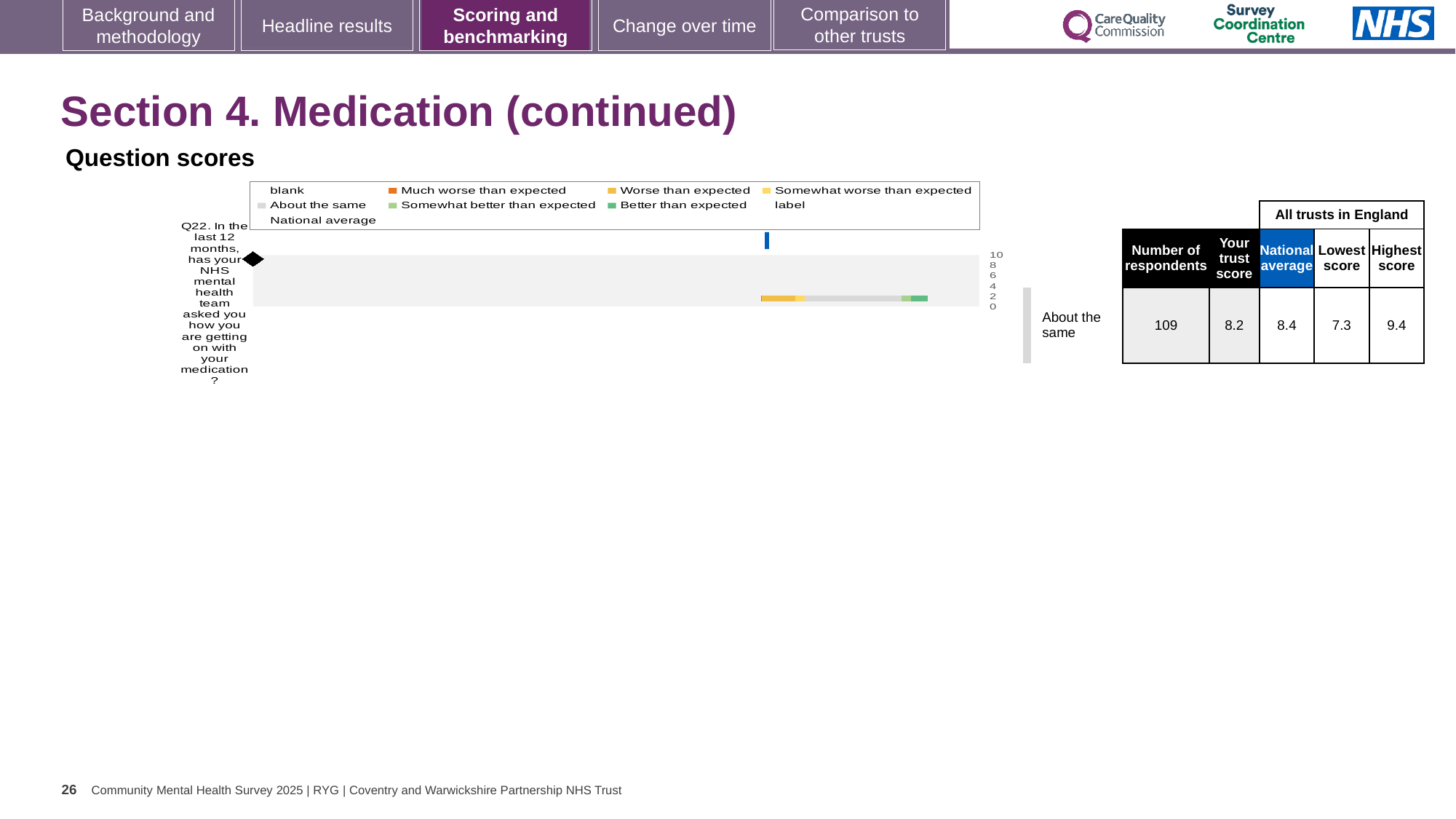
What kind of chart is shown under 'Question scores'? bar chart What is the national average score for Q22? 8.4 Which benchmark category is Q22 assigned to on the slide? About the same What colour does the legend use for 'Much worse than expected'? Orange What is the lowest score among all trusts in England for Q22? 7.3 What is the difference between the highest score and the lowest score for Q22? 2.1 How many respondents answered Q22? 109 What is the trust score for Q22 shown next to the chart? 8.2 Which is larger for Q22, the trust score or the national average? National average How many survey questions are plotted in the Question scores chart? 1 By how much does the national average exceed the trust score for Q22? 0.2 What is the highest score among all trusts in England for Q22? 9.4